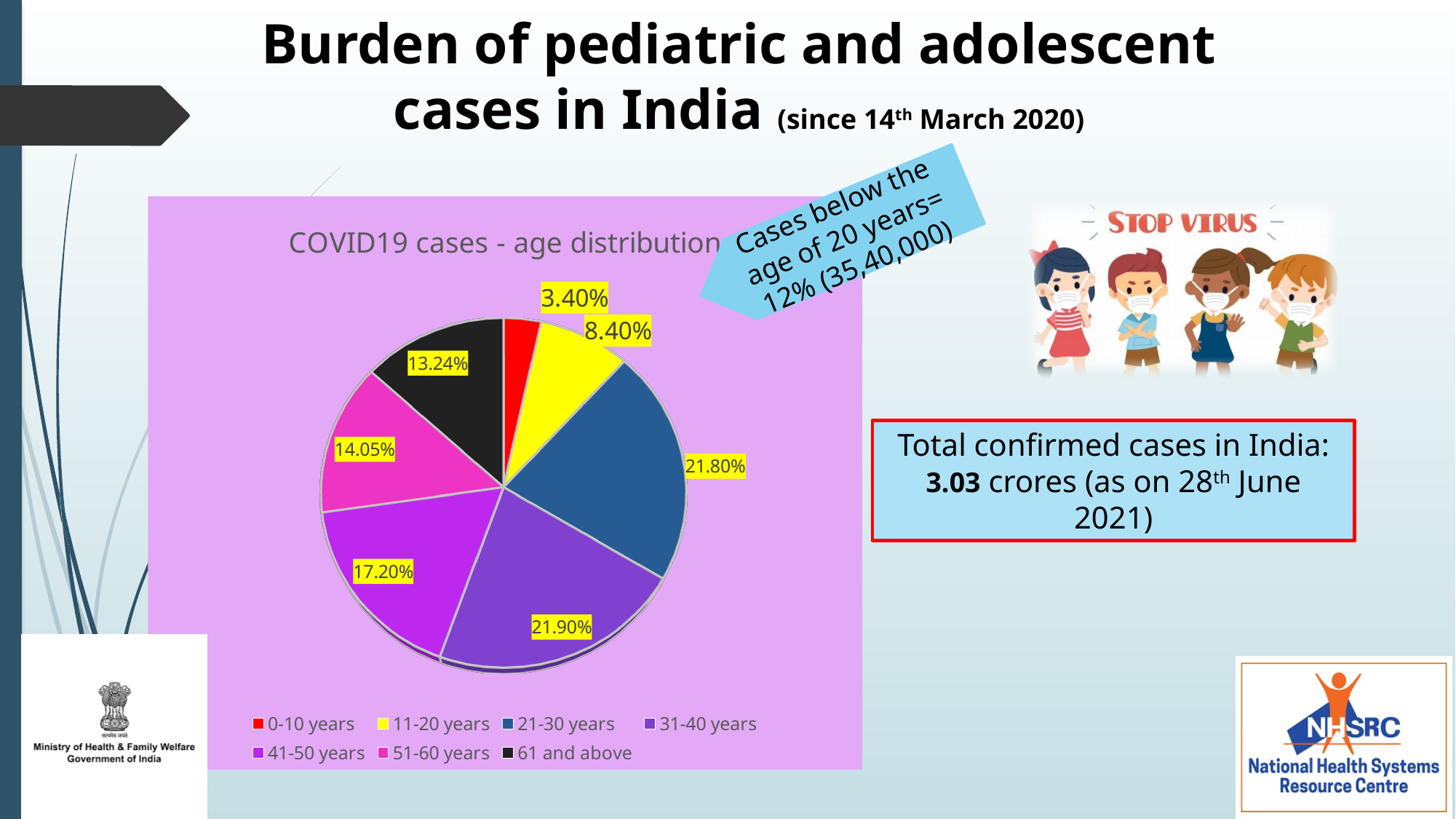
What percentage of cases is shown for the 21-30 years age group? 21.80% What colour represents the 61 and above age group in the chart? black What kind of chart is shown on the slide? pie chart Which age group has the smallest share of cases? 0-10 years What percentage of cases is shown for the 41-50 years age group? 17.20% What is the difference in percentage points between the 41-50 years and 51-60 years groups? 3.15 What percentage of cases is shown for the 61 and above age group? 13.24% How many age groups does the legend list? 7 What percentage of cases is shown for the 0-10 years age group? 3.40% What is the title of the chart? COVID19 cases - age distribution Which has a larger share of cases, the 51-60 years group or the 61 and above group? 51-60 years What percentage of cases is shown for the 11-20 years age group? 8.40%